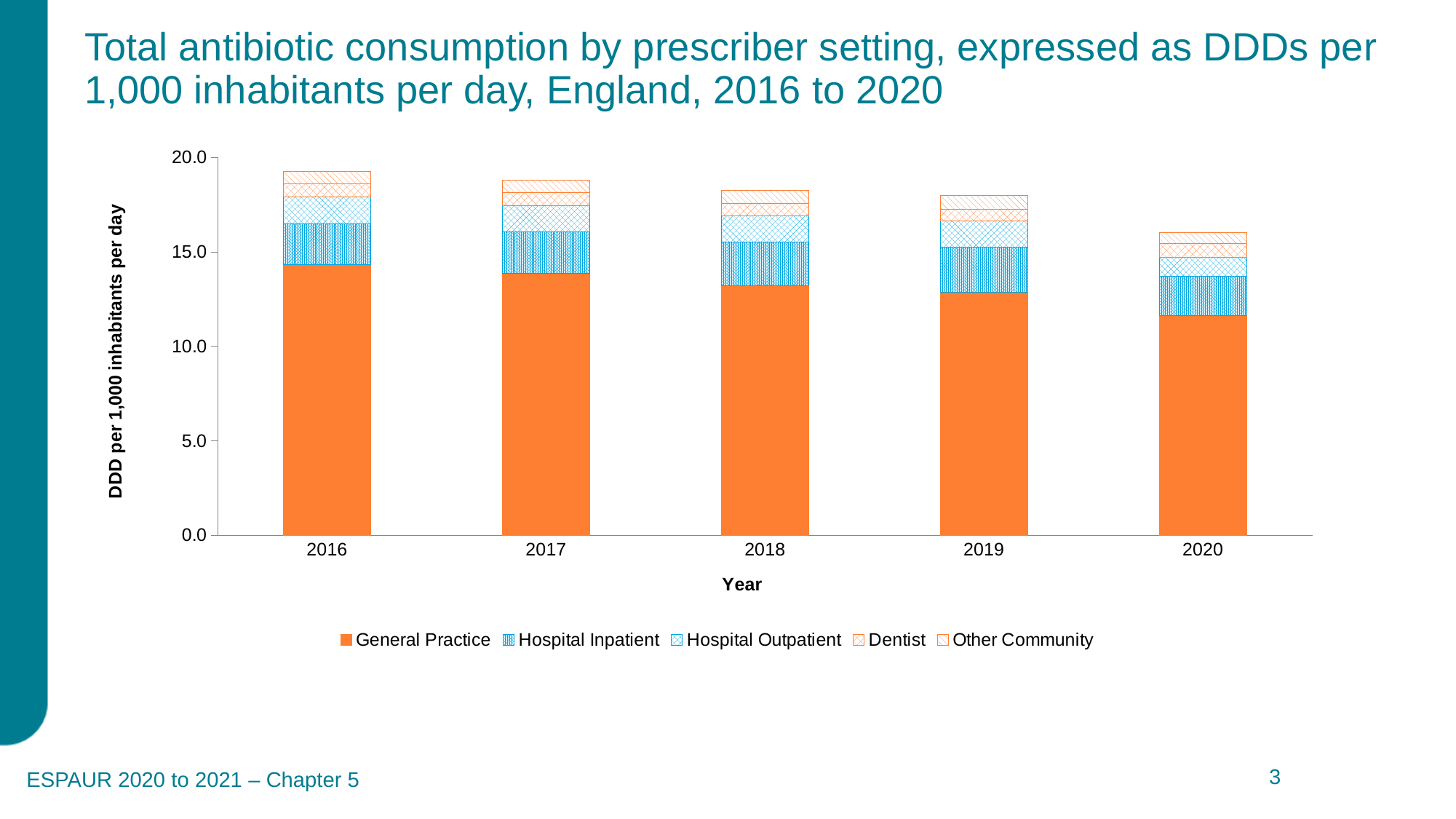
How many years are shown on the x axis? 5 What is the label of the y axis? DDD per 1,000 inhabitants per day Which is larger, the total bar for 2016 or the total bar for 2020? 2016 How many series does the legend list? 5 What kind of chart is shown on the slide? Stacked bar chart Is the total bar for 2020 greater or less than 20.0? less Do the total bar heights rise or fall from 2016 to 2020? Fall Is the General Practice value for 2018 greater or less than 15.0? less Is the General Practice value for 2016 greater or less than 10.0? greater Which series forms the largest segment of each bar? General Practice Which year has the lowest total bar? 2020 Which year has the highest total bar? 2016